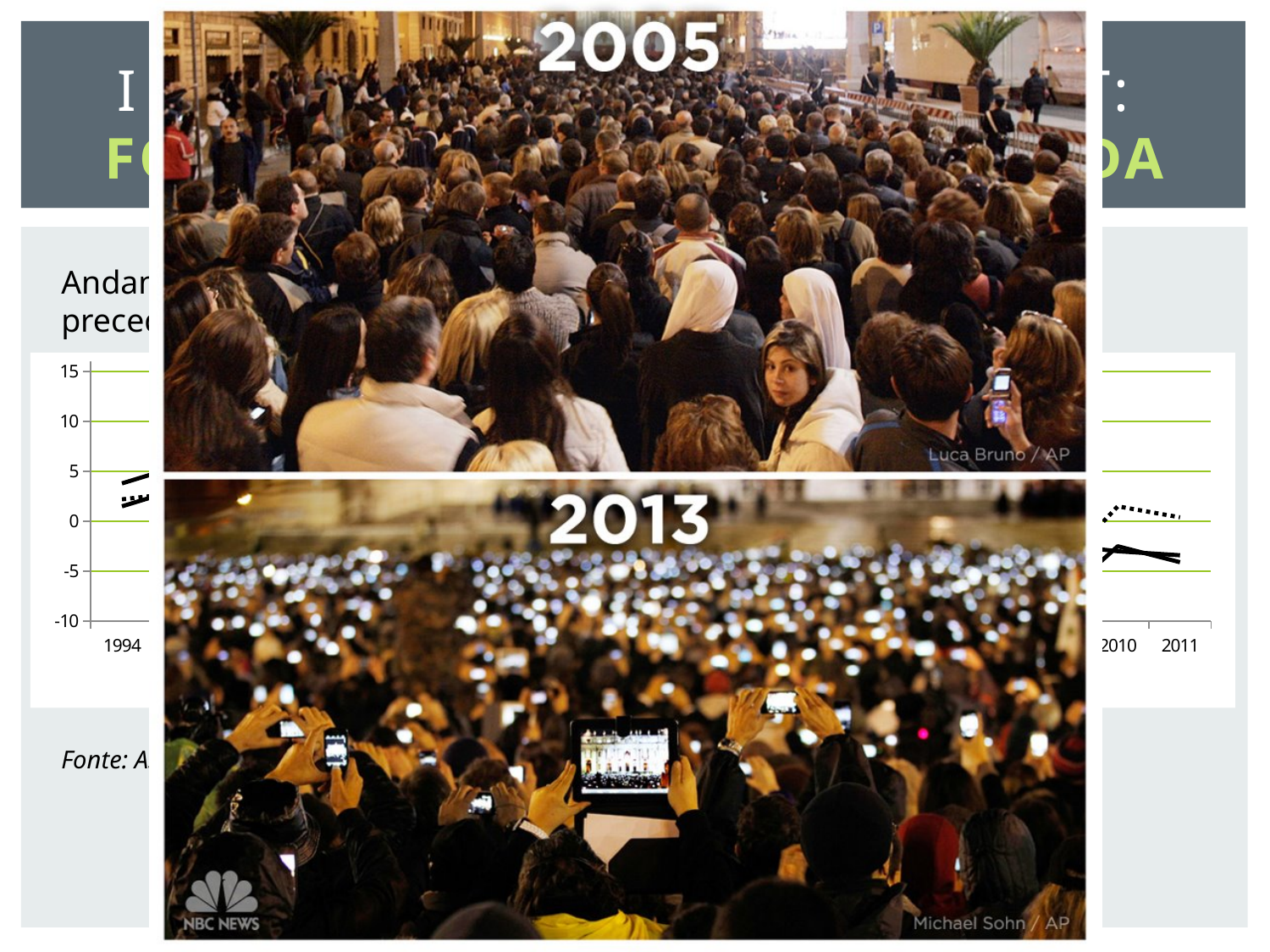
What kind of chart is shown on the slide behind the photographs? line chart Is the value of the dotted line at 2011 greater or less than -5? greater At 2011, which line is higher, the dotted line or the solid line? the dotted line What is the lowest value marked on the chart's y axis? -10 Is the value of the solid line at 2011 greater or less than 0? less What is the first year shown on the x axis of the chart? 1994 What is the last year shown on the x axis of the chart? 2011 Is the value of the dotted line at 1994 greater or less than 0? greater How many lines are visible on the chart? 3